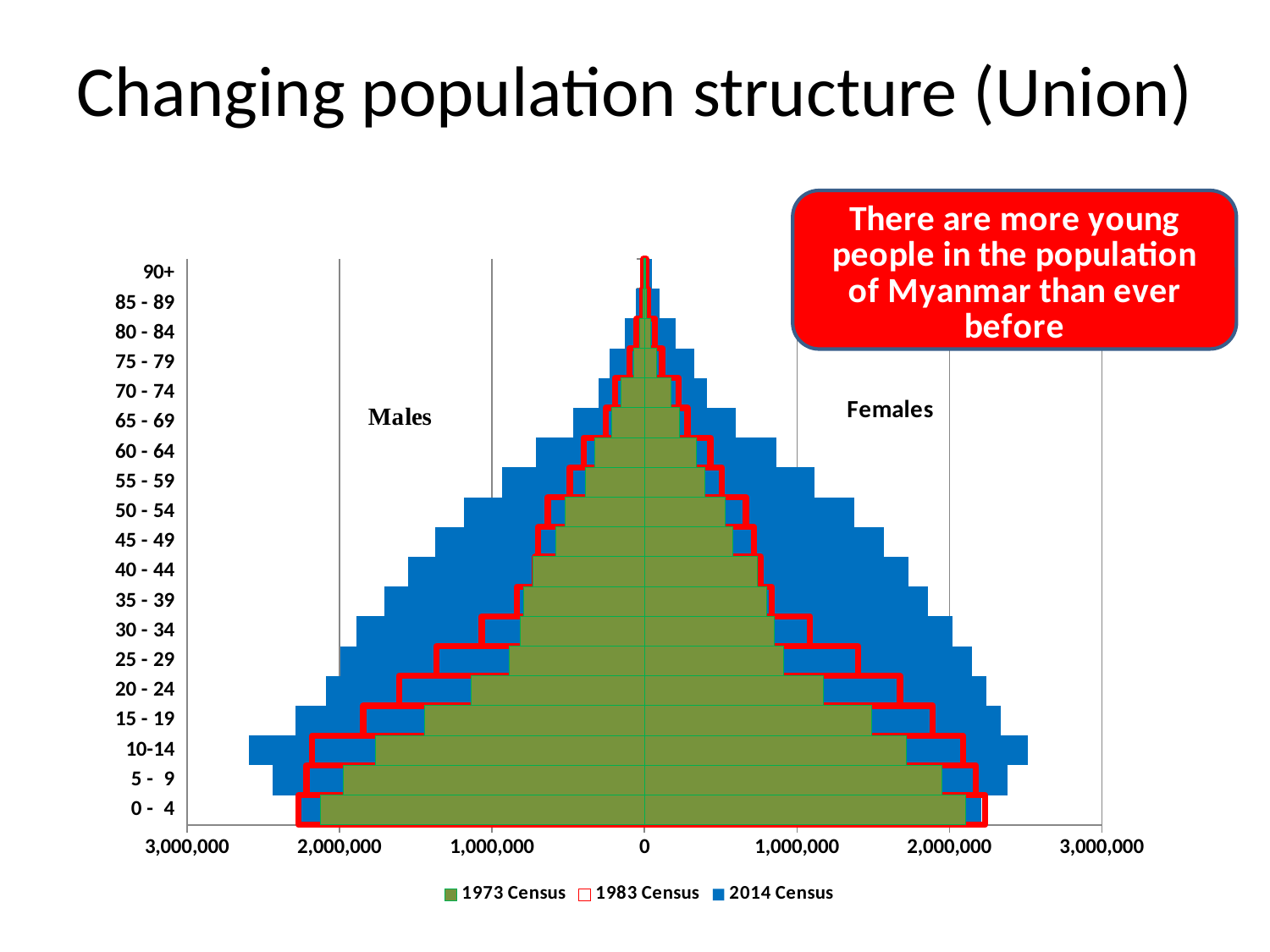
What is the title of the slide containing the chart? Changing population structure (Union) Is the 1973 Census value for males aged 40-44 greater or less than 1,000,000? less Is the 2014 Census value for males aged 10-14 greater or less than 2,000,000? greater Is the 2014 Census value for females aged 10-14 greater or less than 2,000,000? greater How many age groups are shown on the vertical axis? 19 How many series does the legend list? 3 For males aged 10-14, which is larger: the 2014 Census value or the 1973 Census value? 2014 Census Which age group has the smallest population in every census series? 90+ Which age group has the largest 2014 Census male population? 10-14 Which census series is drawn in blue? 2014 Census What kind of chart is shown on the slide? Bar chart (population pyramid)